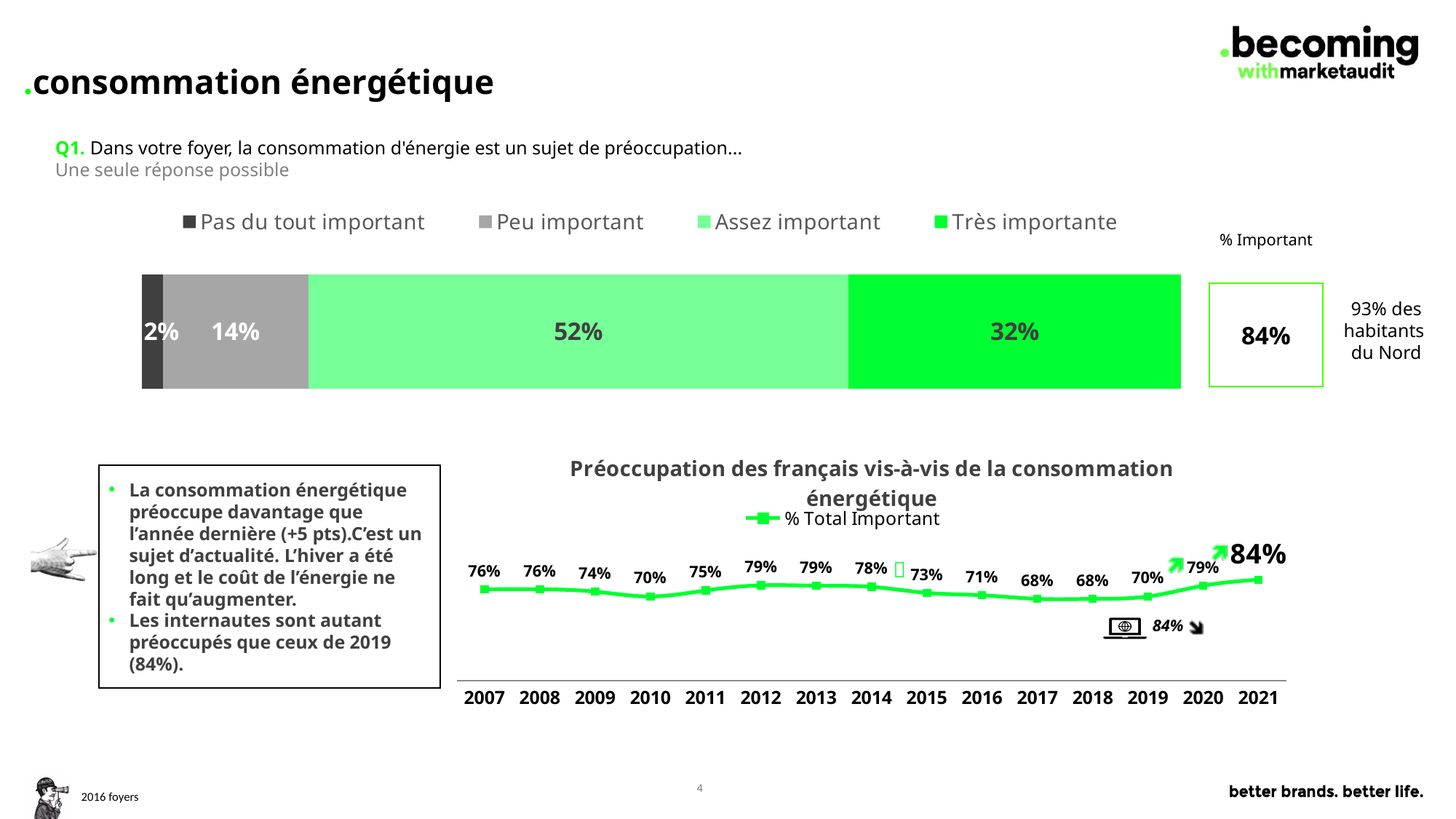
In the stacked bar chart at the top of the slide, which response category has the smallest share? Pas du tout important In the stacked bar chart at the top of the slide, how many series does the legend list? 4 In the line chart 'Préoccupation des français vis-à-vis de la consommation énergétique', what is the difference between the 2021 and 2020 values? 5% In the stacked bar chart at the top of the slide, what is the difference between the 'Assez important' and 'Très importante' shares? 20% In the line chart 'Préoccupation des français vis-à-vis de la consommation énergétique', is the value for 2014 larger or smaller than the value for 2015? larger In the line chart 'Préoccupation des français vis-à-vis de la consommation énergétique', what is the value for 2010? 70% In the line chart 'Préoccupation des français vis-à-vis de la consommation énergétique', which year has the highest value? 2021 In the stacked bar chart at the top of the slide, what percentage is shown for 'Assez important'? 52% In the line chart 'Préoccupation des français vis-à-vis de la consommation énergétique', how many years are plotted on the x axis? 15 What kind of chart is the bottom chart titled 'Préoccupation des français vis-à-vis de la consommation énergétique'? line chart In the stacked bar chart at the top of the slide, what percentage is shown for 'Très importante'? 32% In the line chart 'Préoccupation des français vis-à-vis de la consommation énergétique', what is the value for 2021? 84%